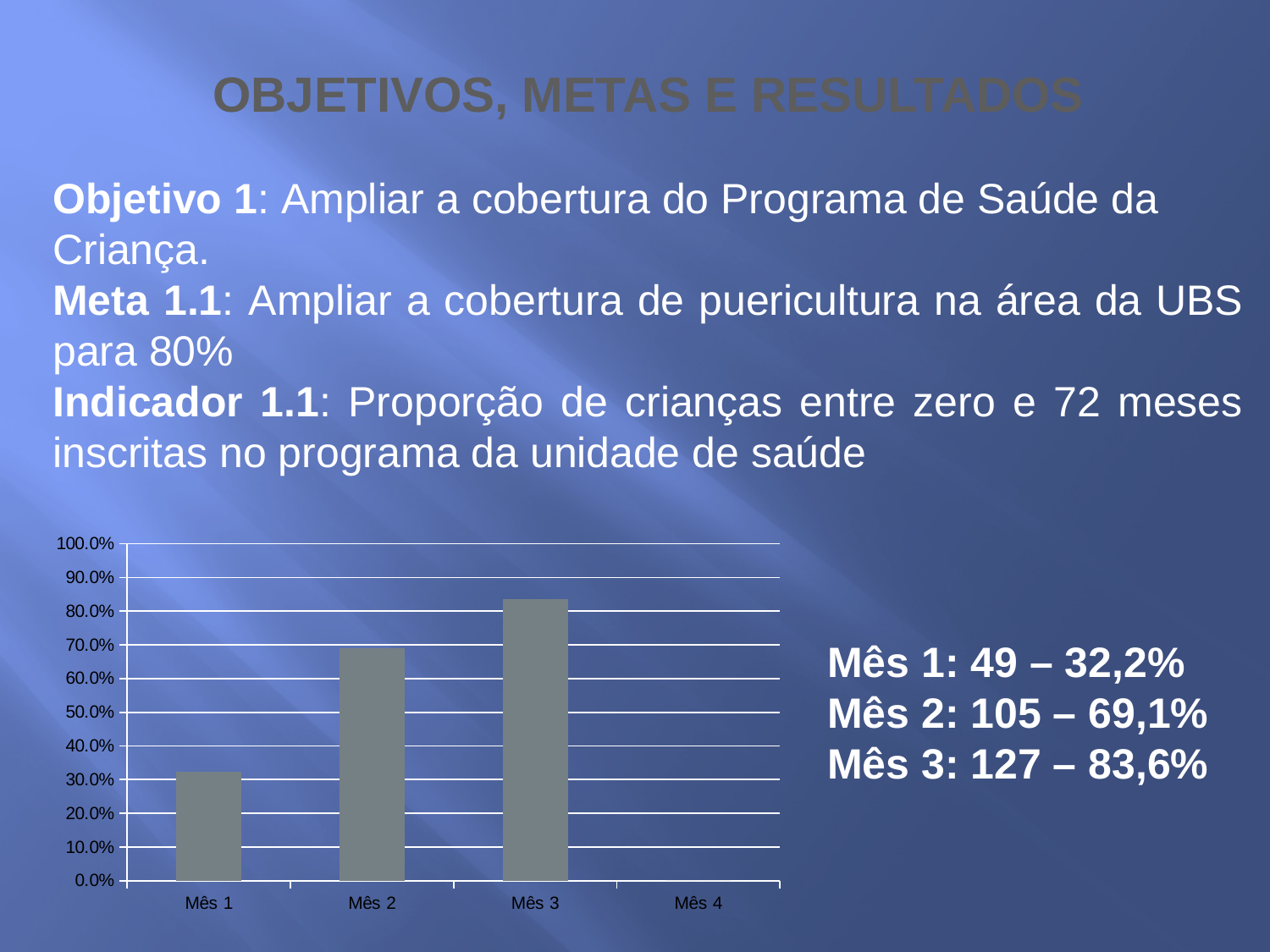
Which month has the highest bar in the chart? Mês 3 Do the bar values rise or fall from Mês 1 to Mês 3? rise Is the value for Mês 2 greater or less than 60.0%? greater What kind of chart is shown on the slide? bar chart Among the months with a bar, which has the lowest value? Mês 1 Is the value for Mês 3 greater or less than 80.0%? greater Is the value for Mês 1 greater or less than 40.0%? less According to the text beside the chart, what percentage is given for Mês 3? 83,6% How many categories are shown on the x axis of the chart? 4 Which is larger, the value for Mês 2 or the value for Mês 3? Mês 3 According to the text beside the chart, what percentage is given for Mês 1? 32,2% What is the highest value shown on the chart's y axis? 100.0%